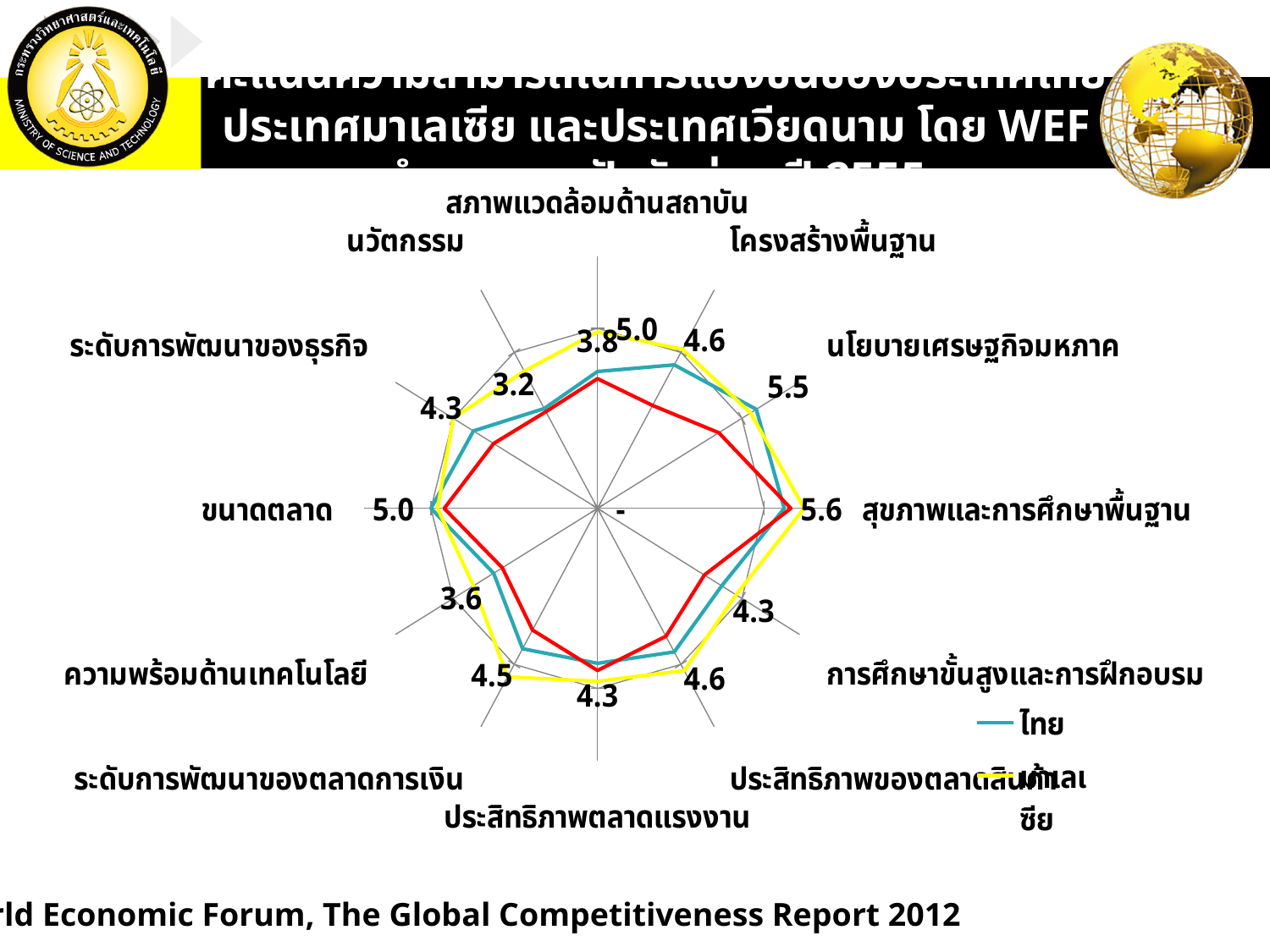
Which category has the lowest labeled value on the chart? นวัตกรรม How many lines (series) are plotted on the radar chart? 3 What is the difference between the labeled values for สุขภาพและการศึกษาพื้นฐาน and นวัตกรรม? 2.4 What data label is shown for สุขภาพและการศึกษาพื้นฐาน? 5.6 Which category has the highest labeled value on the chart? สุขภาพและการศึกษาพื้นฐาน Which colour is used for the ไทย series in the legend? Teal (blue-green) What data label is shown for ขนาดตลาด? 5.0 What data label is shown for ระดับการพัฒนาของตลาดการเงิน? 4.5 How many categories (axes) does the radar chart have? 12 What data label is shown for นโยบายเศรษฐกิจมหภาค? 5.5 What kind of chart is shown on the slide? Radar chart What data label is shown for นวัตกรรม? 3.2